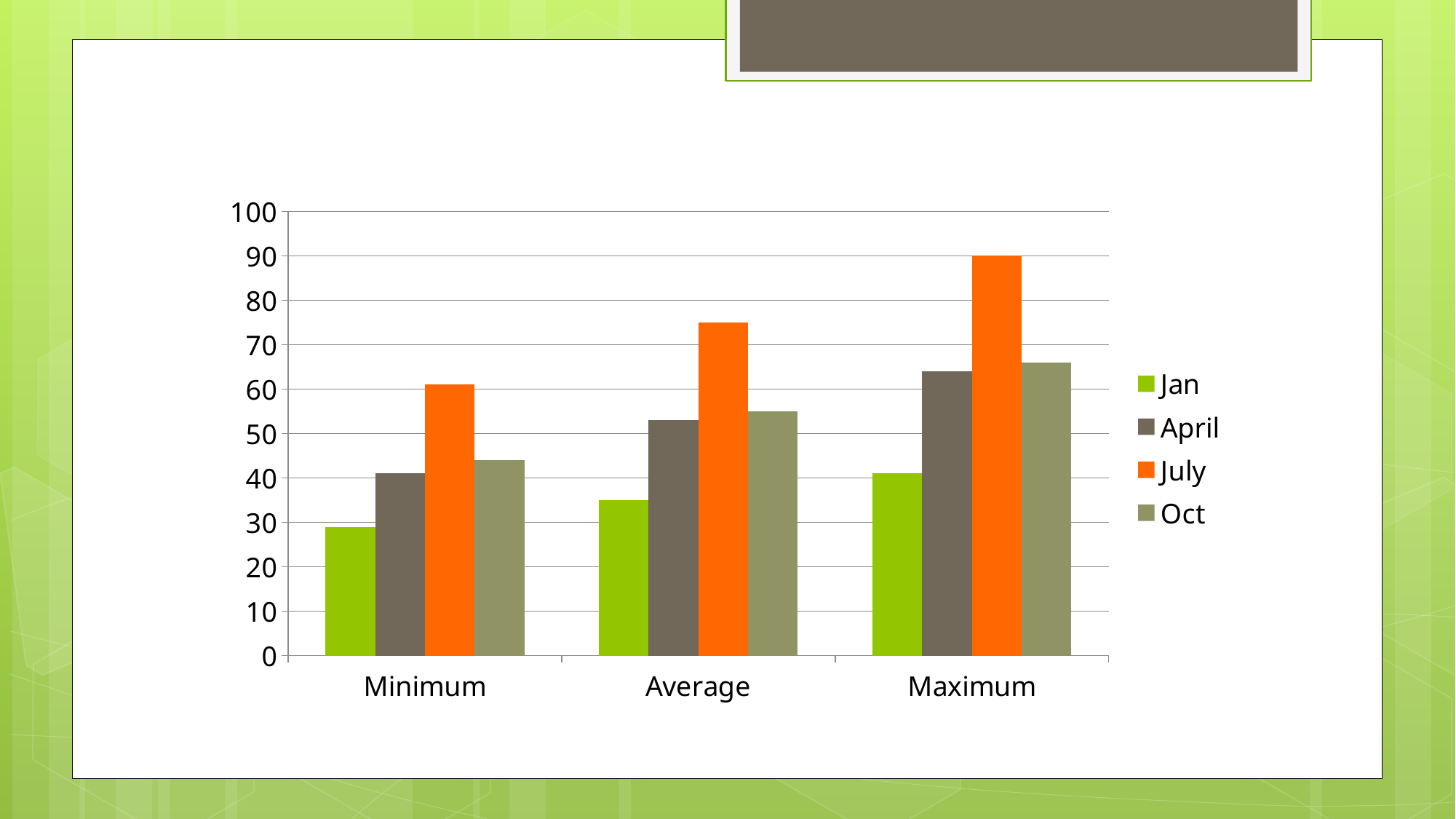
Is the value for Oct in the Minimum category greater or less than 50? less Is the value for Oct in the Maximum category greater or less than 60? greater How many categories are shown on the x axis? 3 How many series does the legend list? 4 Which series has the lowest value in the Average category? Jan What is the value for July in the Maximum category? 90 Do the values for Jan rise or fall from Minimum to Maximum along the x axis? rise Is the value for July in the Average category greater or less than 70? greater What type of chart is shown on the slide? bar chart Which series has the highest value in the Maximum category? July Which is larger: July in the Average category or Oct in the Maximum category? July in the Average category